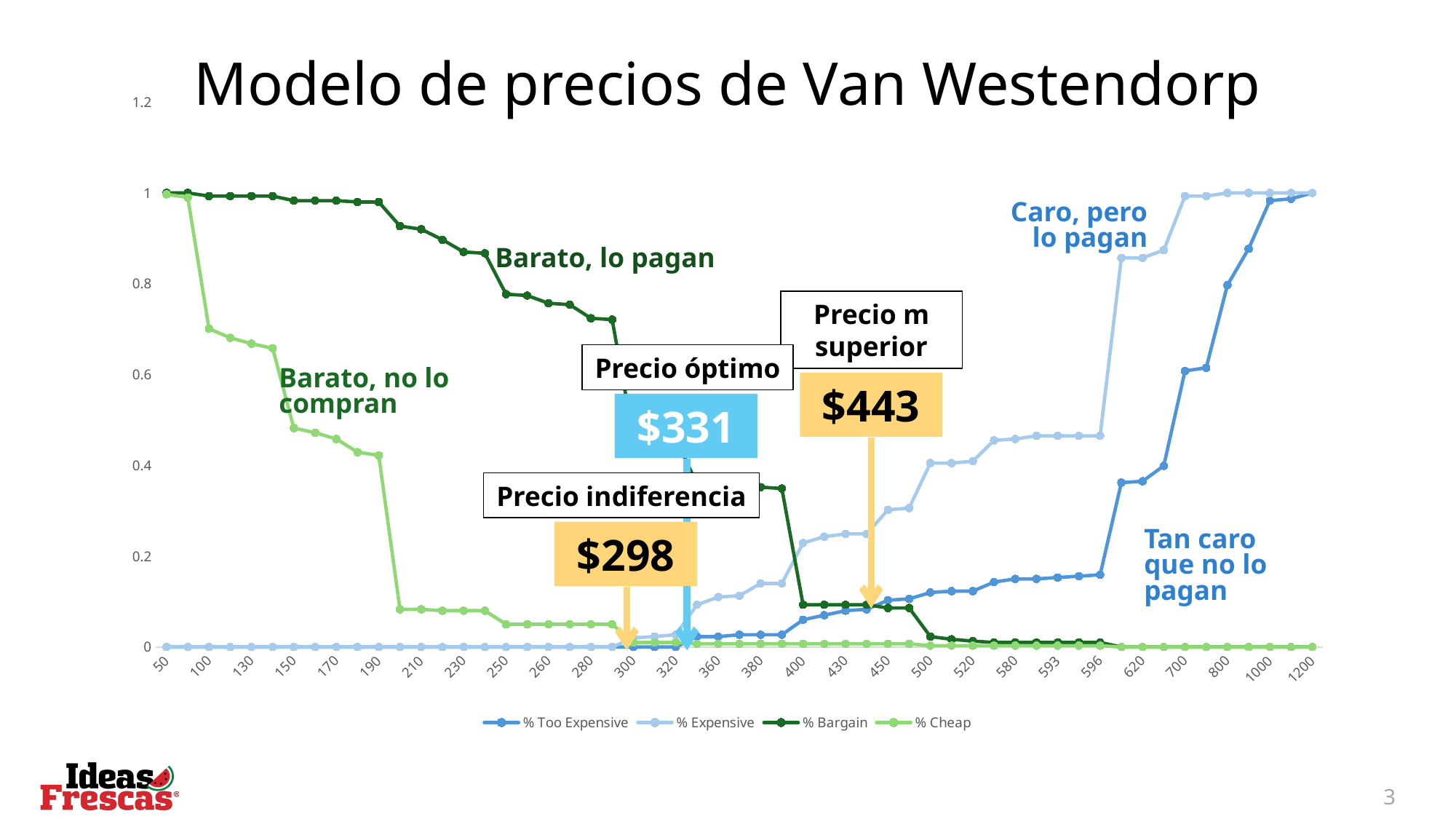
What is the title of the slide's chart? Modelo de precios de Van Westendorp Does the % Cheap series rise or fall as the price increases along the x axis? fall Does the % Too Expensive series rise or fall as the price increases along the x axis? rise How many series does the legend list? 4 Is the value of % Too Expensive at 500 greater or less than 0.2? less What price is labelled as 'Precio indiferencia' on the chart? $298 At a price of 1200, which is larger: % Expensive or % Cheap? % Expensive What price is labelled as 'Precio m superior' on the chart? $443 What price is labelled as 'Precio óptimo' on the chart? $331 What kind of chart is shown on the slide? line chart Is the value of % Cheap at 50 greater or less than 0.8? greater